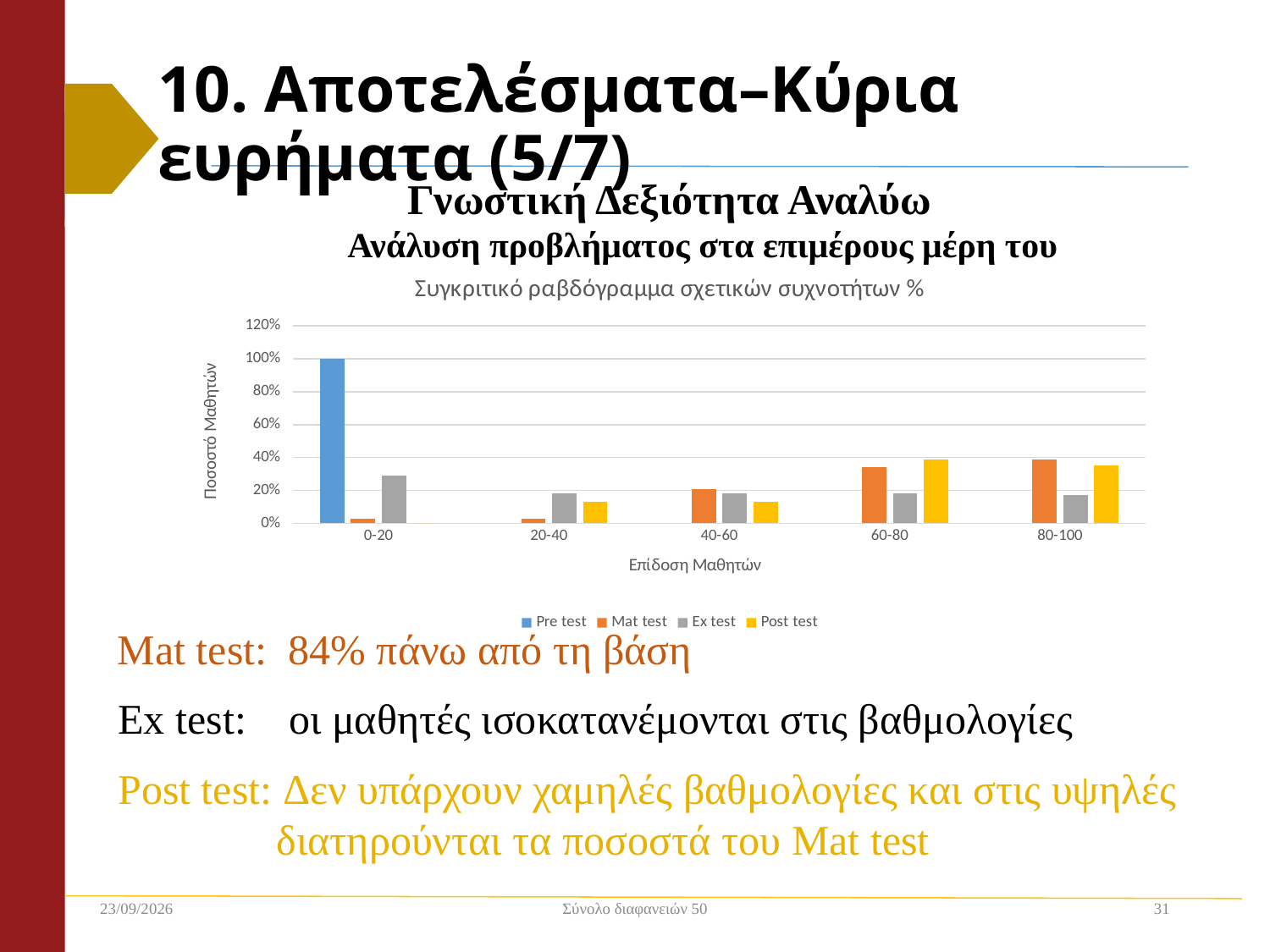
In the 60-80 category, which is larger: the Mat test value or the Ex test value? Mat test What is the label of the vertical axis of the chart? Ποσοστό Μαθητών How many score categories are shown on the x axis of the chart? 5 Is the Mat test value for the 60-80 category greater or less than 20%? greater Which category has the highest Ex test value? 0-20 What kind of chart is shown on the slide? bar chart Is the Ex test value for the 0-20 category greater or less than 20%? greater What is the Pre test value for the 0-20 category? 100% Is the Post test value for the 20-40 category greater or less than 20%? less How many series does the legend of the chart list? 4 Which category has the highest Pre test value? 0-20 In the 80-100 category, which is larger: the Post test value or the Ex test value? Post test